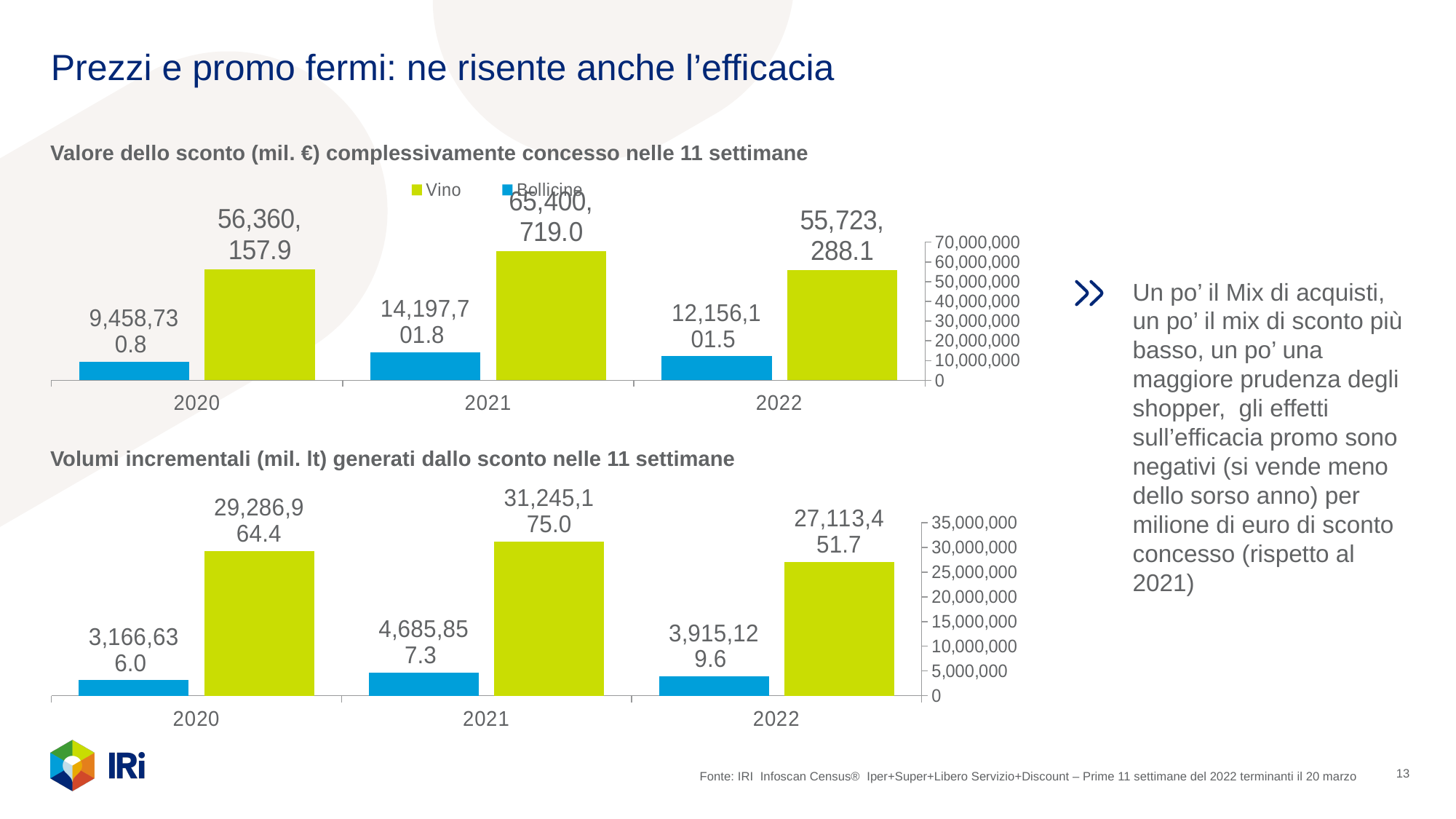
In the chart 'Valore dello sconto (mil. €) complessivamente concesso nelle 11 settimane', is the value for Vino in 2022 greater or less than 50,000,000? greater In the chart 'Volumi incrementali (mil. lt) generati dallo sconto nelle 11 settimane', which is larger: the Vino value for 2020 or for 2022? 2020 In the chart 'Volumi incrementali (mil. lt) generati dallo sconto nelle 11 settimane', what is the value for Bollicine in 2021? 4,685,857.3 What kind of chart is the bottom chart 'Volumi incrementali (mil. lt) generati dallo sconto nelle 11 settimane'? Bar chart In the chart 'Valore dello sconto (mil. €) complessivamente concesso nelle 11 settimane', what is the value for Vino in 2021? 65,400,719.0 In the chart 'Volumi incrementali (mil. lt) generati dallo sconto nelle 11 settimane', what is the difference between the Bollicine values for 2021 and 2020? 1,519,221.3 In the chart 'Valore dello sconto (mil. €) complessivamente concesso nelle 11 settimane', which year has the lowest value for Bollicine? 2020 In the chart 'Valore dello sconto (mil. €) complessivamente concesso nelle 11 settimane', what is the difference between the Vino values for 2021 and 2022? 9,677,430.9 How many series does the legend list for the charts on this slide? 2 In the chart 'Valore dello sconto (mil. €) complessivamente concesso nelle 11 settimane', what is the value for Bollicine in 2020? 9,458,730.8 In the chart 'Valore dello sconto (mil. €) complessivamente concesso nelle 11 settimane', which year has the highest value for Vino? 2021 In the chart 'Volumi incrementali (mil. lt) generati dallo sconto nelle 11 settimane', what is the value for Vino in 2022? 27,113,451.7